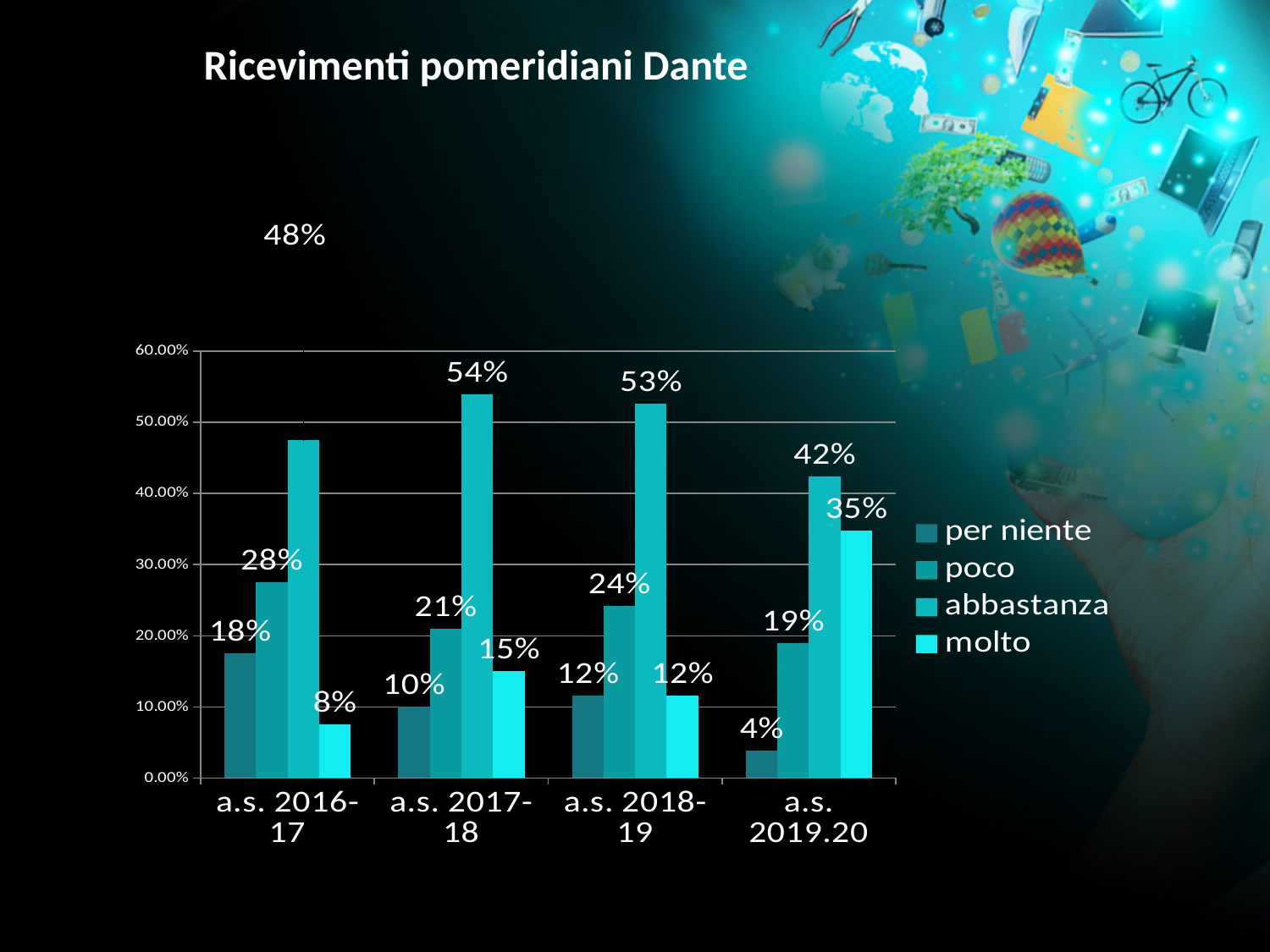
What kind of chart is shown on the slide? bar chart What is the value for "abbastanza" in a.s. 2017-18? 54% In which school year is the value for "molto" highest? a.s. 2019.20 Which is larger: "poco" in a.s. 2016-17 or "poco" in a.s. 2019.20? poco in a.s. 2016-17 What is the value for "molto" in a.s. 2019.20? 35% What is the value for "poco" in a.s. 2018-19? 24% How many school-year categories are shown on the x axis? 4 In which school year is the value for "per niente" lowest? a.s. 2019.20 What is the difference between the "abbastanza" value in a.s. 2017-18 and in a.s. 2019.20? 12% How many series does the legend list? 4 Is the value for "abbastanza" in a.s. 2016-17 greater or less than 40.00%? greater What is the value for "per niente" in a.s. 2016-17? 18%